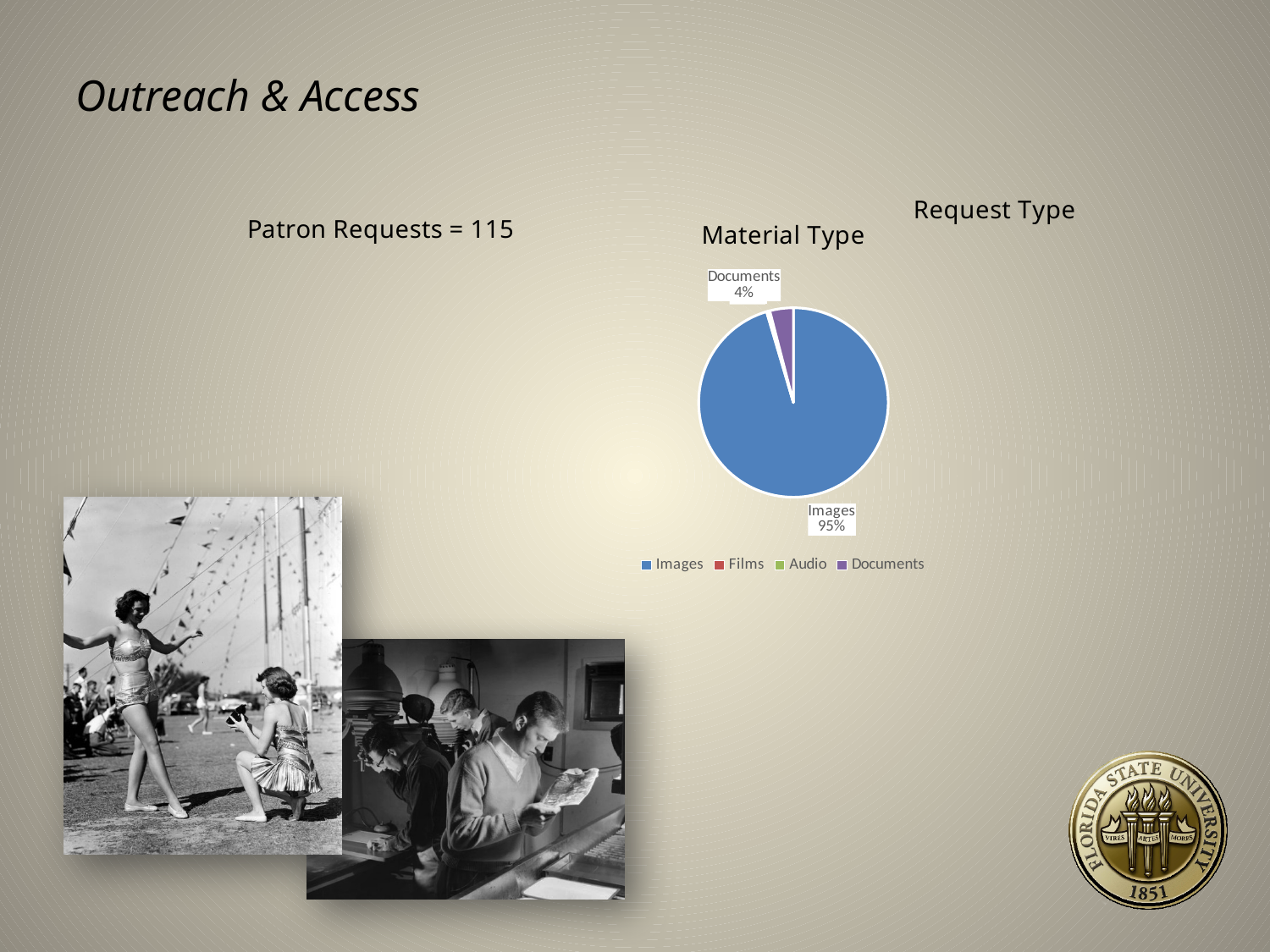
What share of the Material Type pie chart is Documents? 4% Which material type has the largest slice in the Material Type pie chart? Images What is the difference in percentage points between the Images and Documents slices in the Material Type pie chart? 91 Is the Documents share in the Material Type pie chart greater or less than 10%? less What is the title of the pie chart on the slide? Material Type What share of the Material Type pie chart is Images? 95% What kind of chart is the Material Type chart? Pie chart Which of the two labelled slices in the Material Type pie chart is larger, Images or Documents? Images What colour is the Images slice in the Material Type pie chart? Blue Is the Images share in the Material Type pie chart greater or less than 50%? greater How many entries does the legend of the Material Type chart list? 4